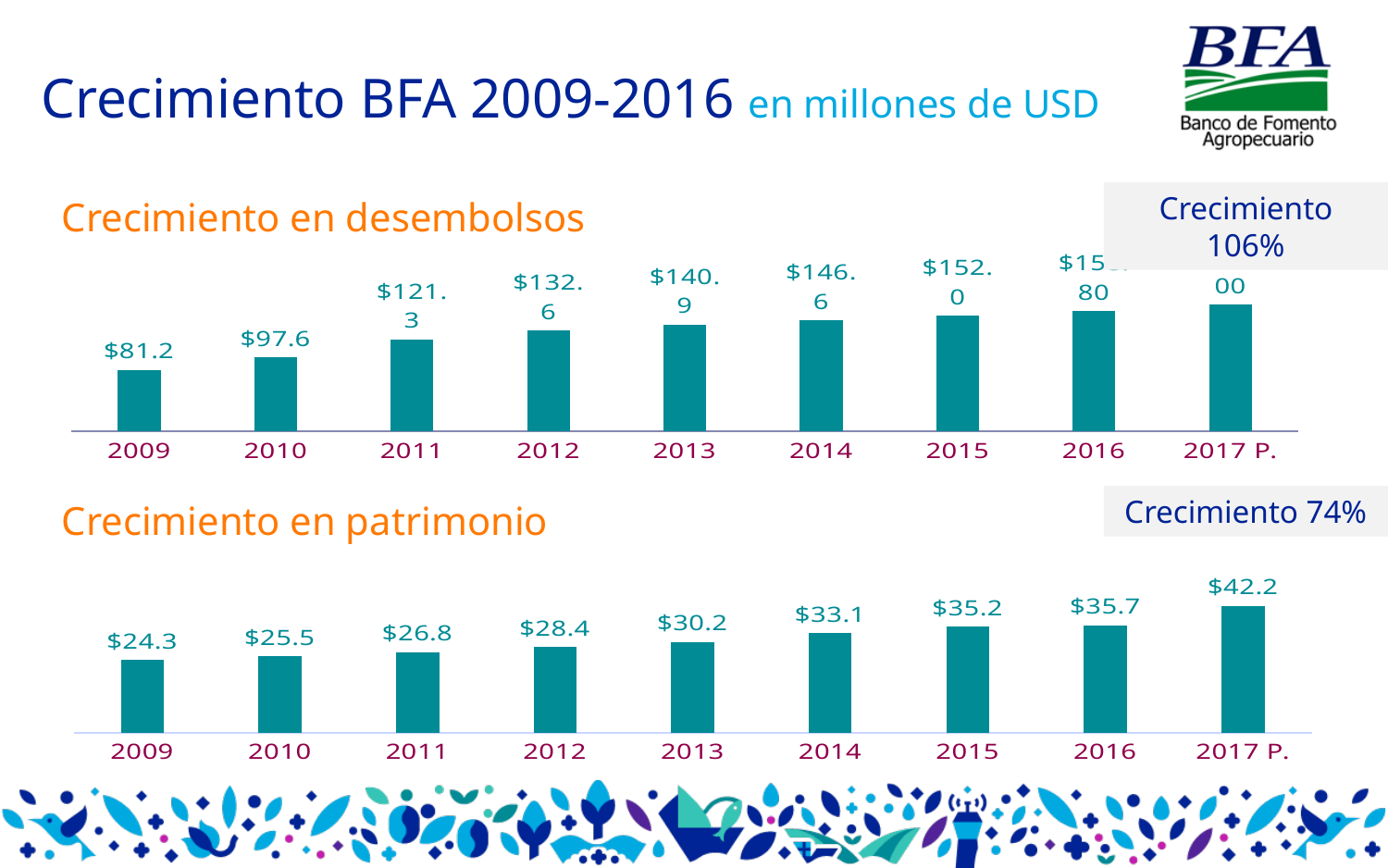
What kind of chart is the 'Crecimiento en desembolsos' chart? Bar chart In the 'Crecimiento en patrimonio' chart, which year has the highest value? 2017 P. How many years are shown on the x axis of the 'Crecimiento en patrimonio' chart? 9 In the 'Crecimiento en patrimonio' chart, do the values rise or fall from 2009 to 2017 P.? Rise In the 'Crecimiento en patrimonio' chart, what is the value for 2014? $33.1 In the 'Crecimiento en patrimonio' chart, which is larger, the value for 2012 or the value for 2015? 2015 In the 'Crecimiento en desembolsos' chart, what is the value for 2013? $140.9 What growth percentage is shown in the box next to the 'Crecimiento en patrimonio' chart? Crecimiento 74% In the 'Crecimiento en desembolsos' chart, what is the difference between the 2015 value and the 2010 value? $54.4 In the 'Crecimiento en desembolsos' chart, which year has the lowest value? 2009 In the 'Crecimiento en patrimonio' chart, what is the difference between the 2017 P. value and the 2009 value? $17.9 In the 'Crecimiento en desembolsos' chart, what is the value for 2009? $81.2